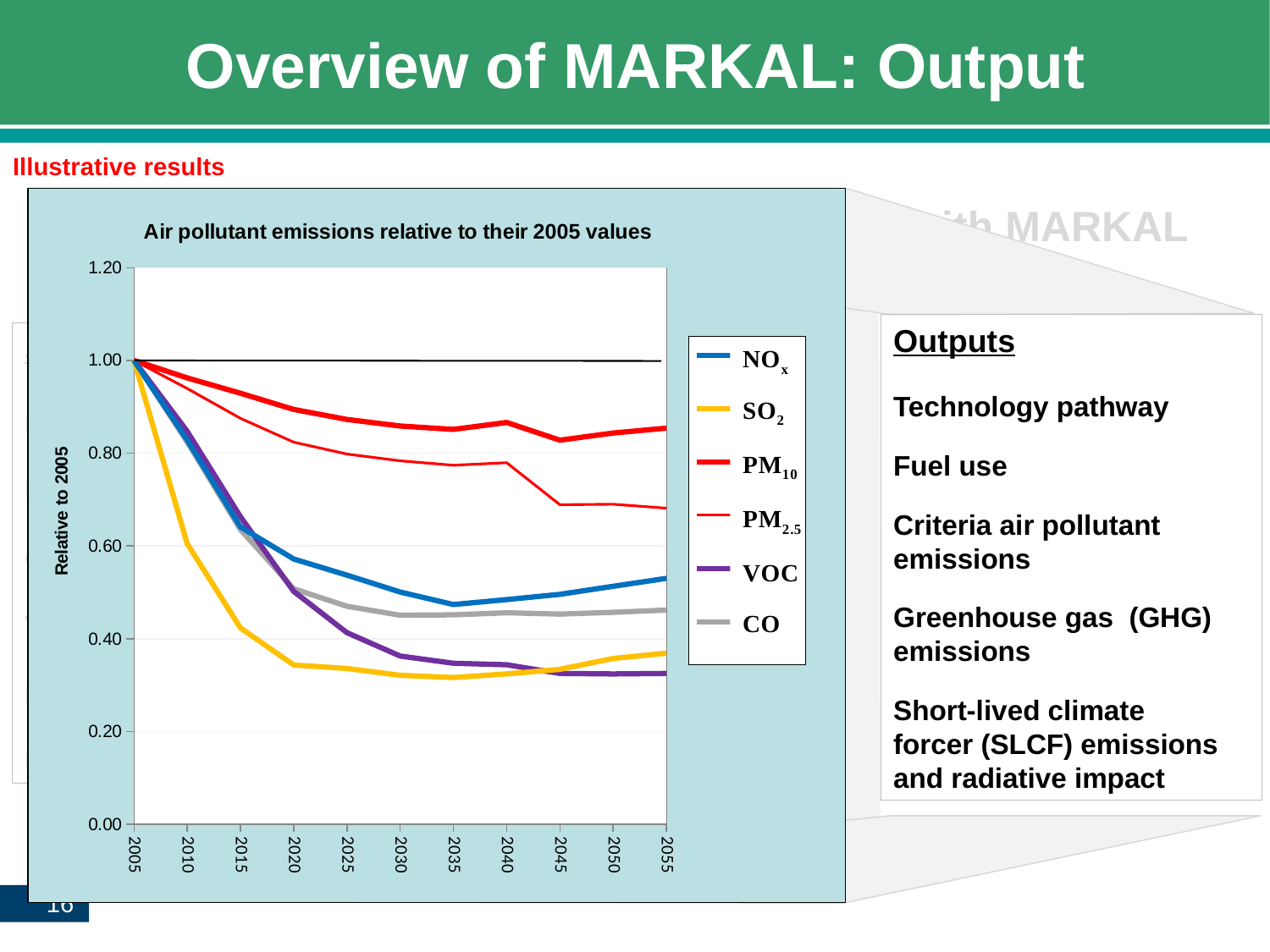
How many years are marked along the x axis of the chart? 11 Is the value for SO2 in 2020 greater or less than 0.40? less Which pollutant has the lowest value in 2020? SO2 How many series does the legend of the chart list? 6 Does SO2 rise or fall between 2005 and 2020? fall Is the value for NOx in 2035 greater or less than 0.60? less Which pollutant has the highest value in 2055? PM10 What is the label on the y axis of the chart? Relative to 2005 Is the value for PM2.5 in 2055 greater or less than 0.80? less What kind of chart is shown on the slide? Line chart What is the value of every series in 2005? 1.00